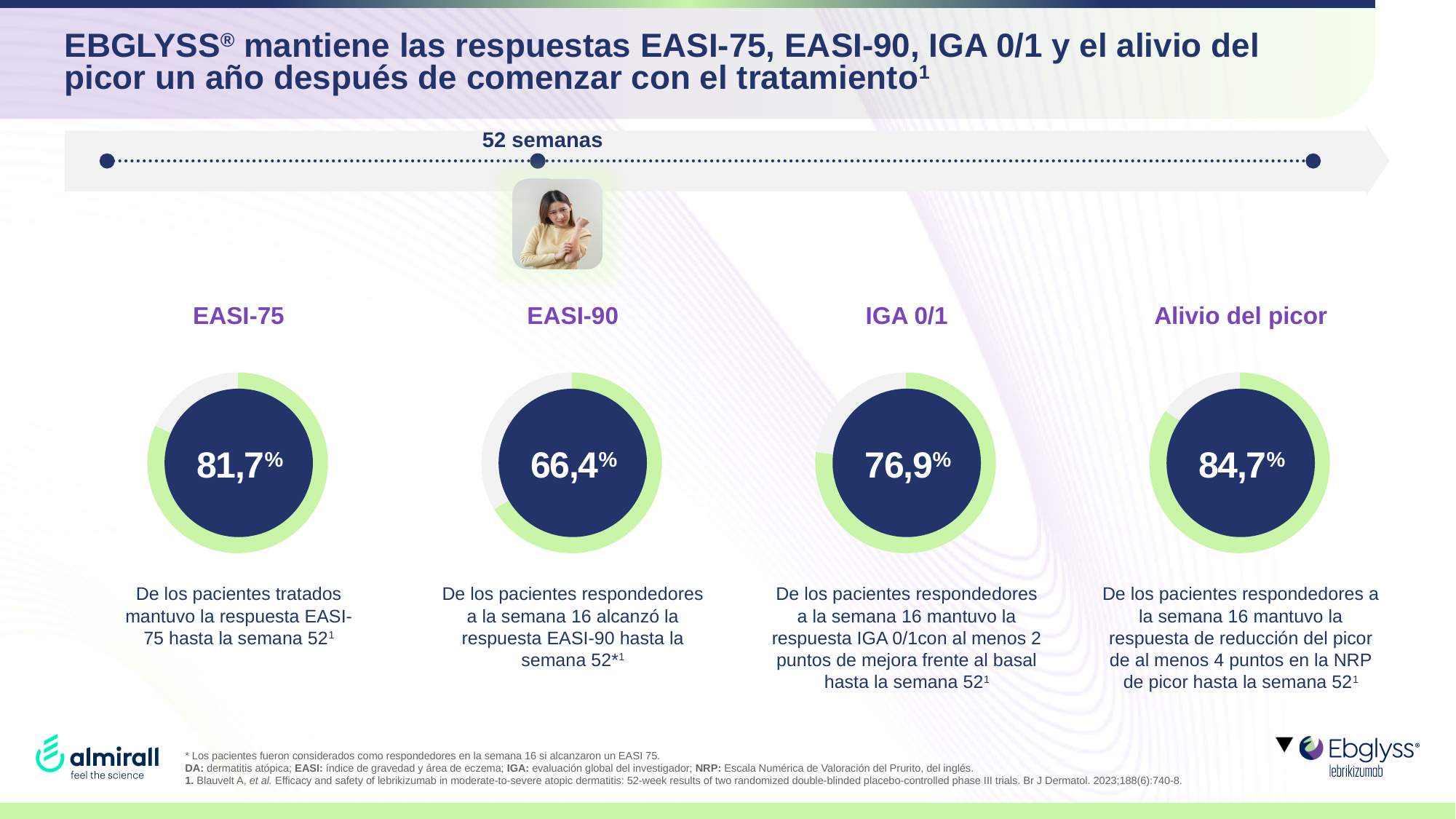
What is the difference between the 'Alivio del picor' value and the EASI-75 value? 3,0 percentage points What value is shown in the EASI-75 donut chart? 81,7% What is the difference between the EASI-75 value and the EASI-90 value? 15,3 percentage points How many donut charts are shown on the slide? 4 Which of the four donut charts shows the lowest percentage? EASI-90 What value is shown in the 'Alivio del picor' donut chart? 84,7% What value is shown in the EASI-90 donut chart? 66,4% What colour is the filled portion of the ring in each donut chart? Green Which of the four donut charts shows the highest percentage? Alivio del picor What value is shown in the IGA 0/1 donut chart? 76,9% What kind of chart is used to display the four percentages? Donut chart Which is larger, the IGA 0/1 value or the EASI-90 value? IGA 0/1